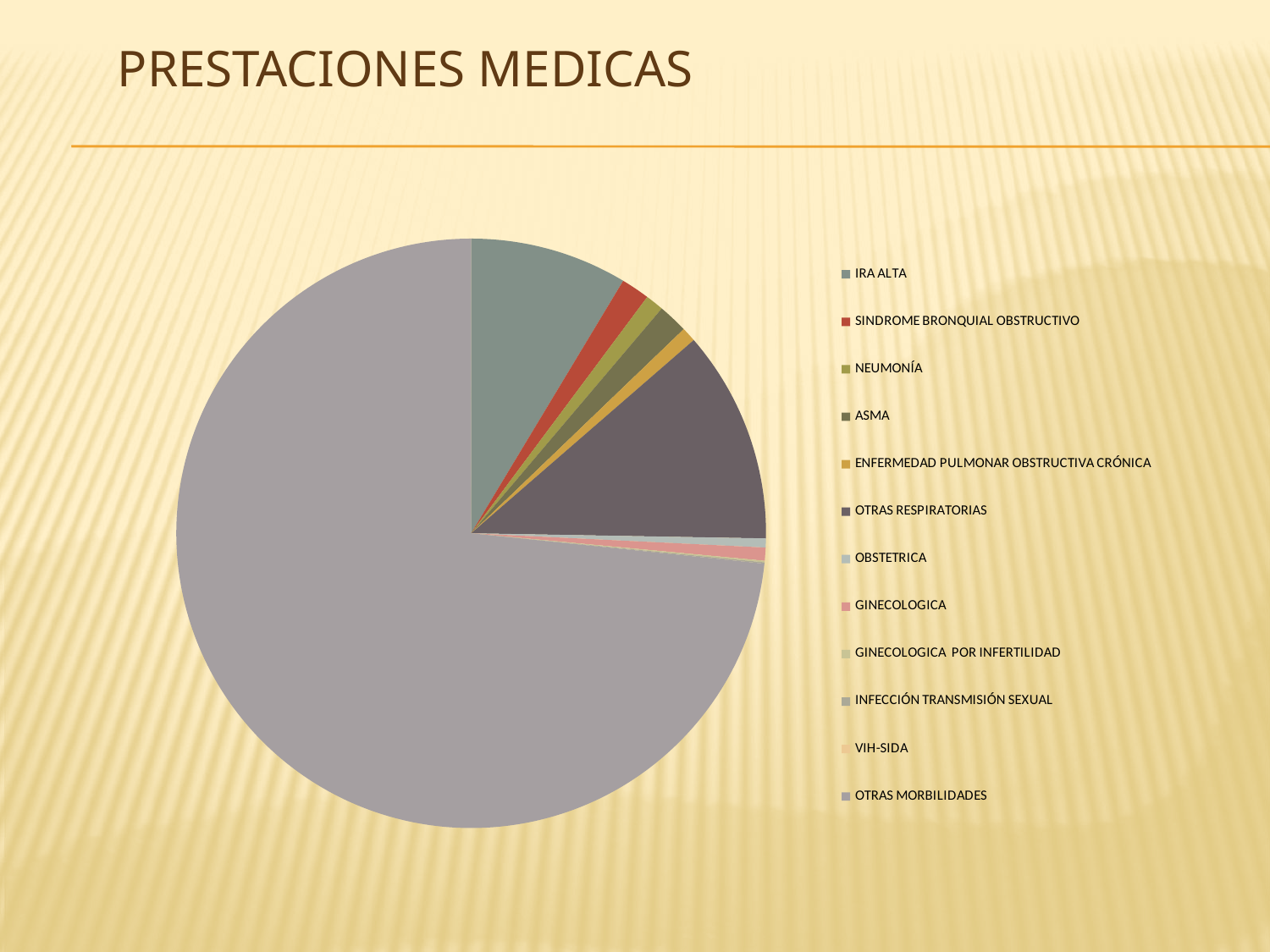
Which category is listed first in the pie chart's legend? IRA ALTA How many categories does the pie chart's legend list? 12 Which slice is larger, OTRAS MORBILIDADES or IRA ALTA? OTRAS MORBILIDADES Which slice is larger, OTRAS RESPIRATORIAS or ASMA? OTRAS RESPIRATORIAS Which slice is larger, IRA ALTA or ENFERMEDAD PULMONAR OBSTRUCTIVA CRÓNICA? IRA ALTA What kind of chart is shown on the slide? pie chart Which category has the largest slice of the pie chart? OTRAS MORBILIDADES What is the title of the slide containing the pie chart? PRESTACIONES MEDICAS